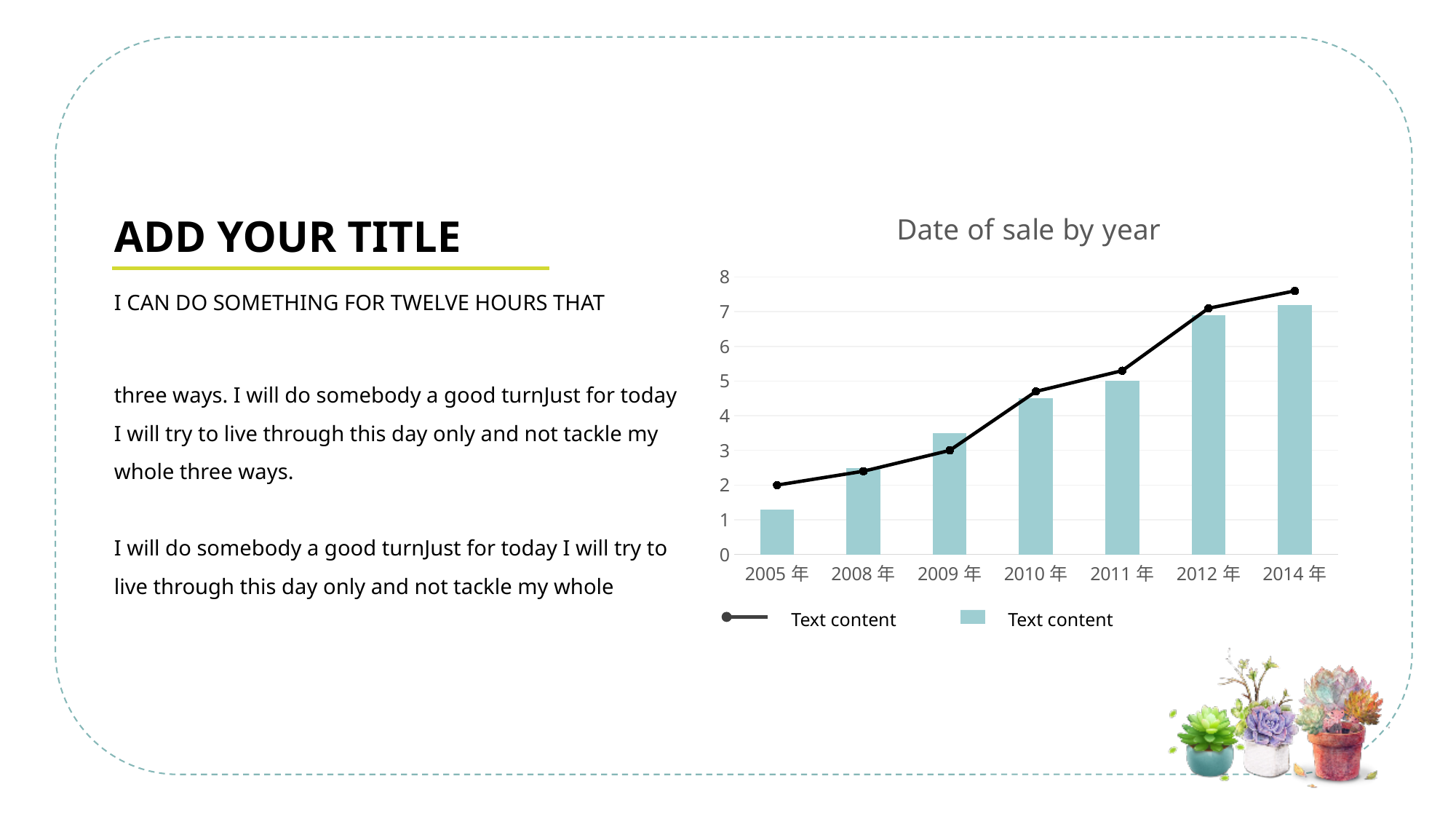
Is the bar value for 2005 年 greater or less than 2? less Do the bar values rise or fall from 2005 年 to 2014 年? Rise Which bar is taller, 2011 年 or 2009 年? 2011 年 Which year has the tallest bar in the chart? 2014 年 Is the line value for 2014 年 greater or less than 7? greater Is the bar value for 2012 年 greater or less than 6? greater How many series does the chart's legend list? 2 What is the title of the chart? Date of sale by year What is the line series value for 2005 年? 2 How many year categories are shown on the x axis of the chart? 7 Which year has the shortest bar in the chart? 2005 年 What kind of chart is shown under the title "Date of sale by year"? A combined bar and line chart